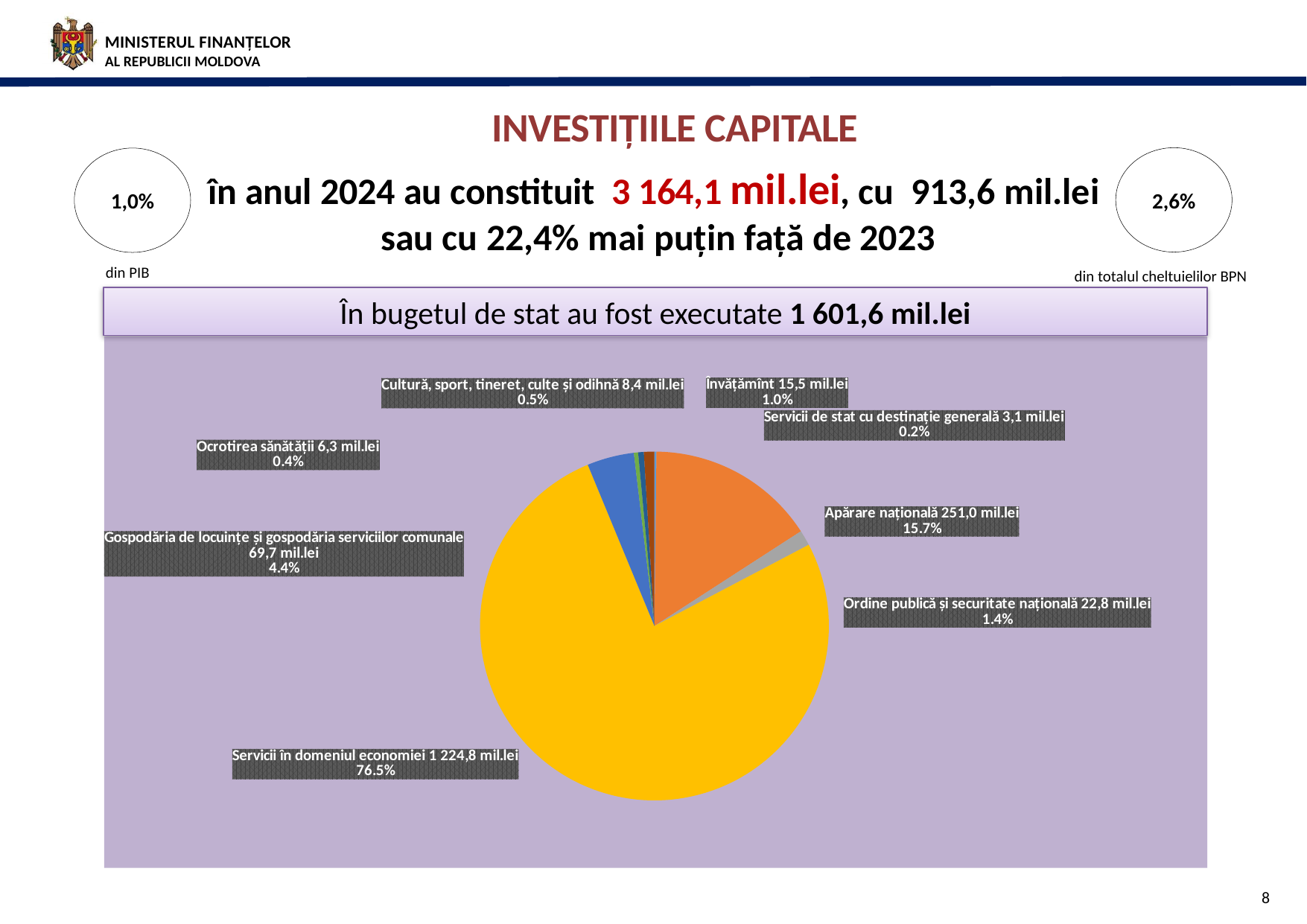
What share of the pie does Învățămînt represent? 1.0% What share of the pie does Apărare națională represent? 15.7% What is the difference between the values for Apărare națională and Ordine publică și securitate națională? 228,2 mil.lei What is the value for Servicii în domeniul economiei? 1 224,8 mil.lei How many categories (slices) does the pie chart show? 8 Which is larger: the value for Ocrotirea sănătății or the value for Învățămînt? Învățămînt What is the value for Gospodăria de locuințe și gospodăria serviciilor comunale? 69,7 mil.lei What is the value for Apărare națională? 251,0 mil.lei What is the value for Ordine publică și securitate națională? 22,8 mil.lei Which category has the smallest slice of the pie? Servicii de stat cu destinație generală What kind of chart is shown on the slide? pie chart Which category has the largest slice of the pie? Servicii în domeniul economiei